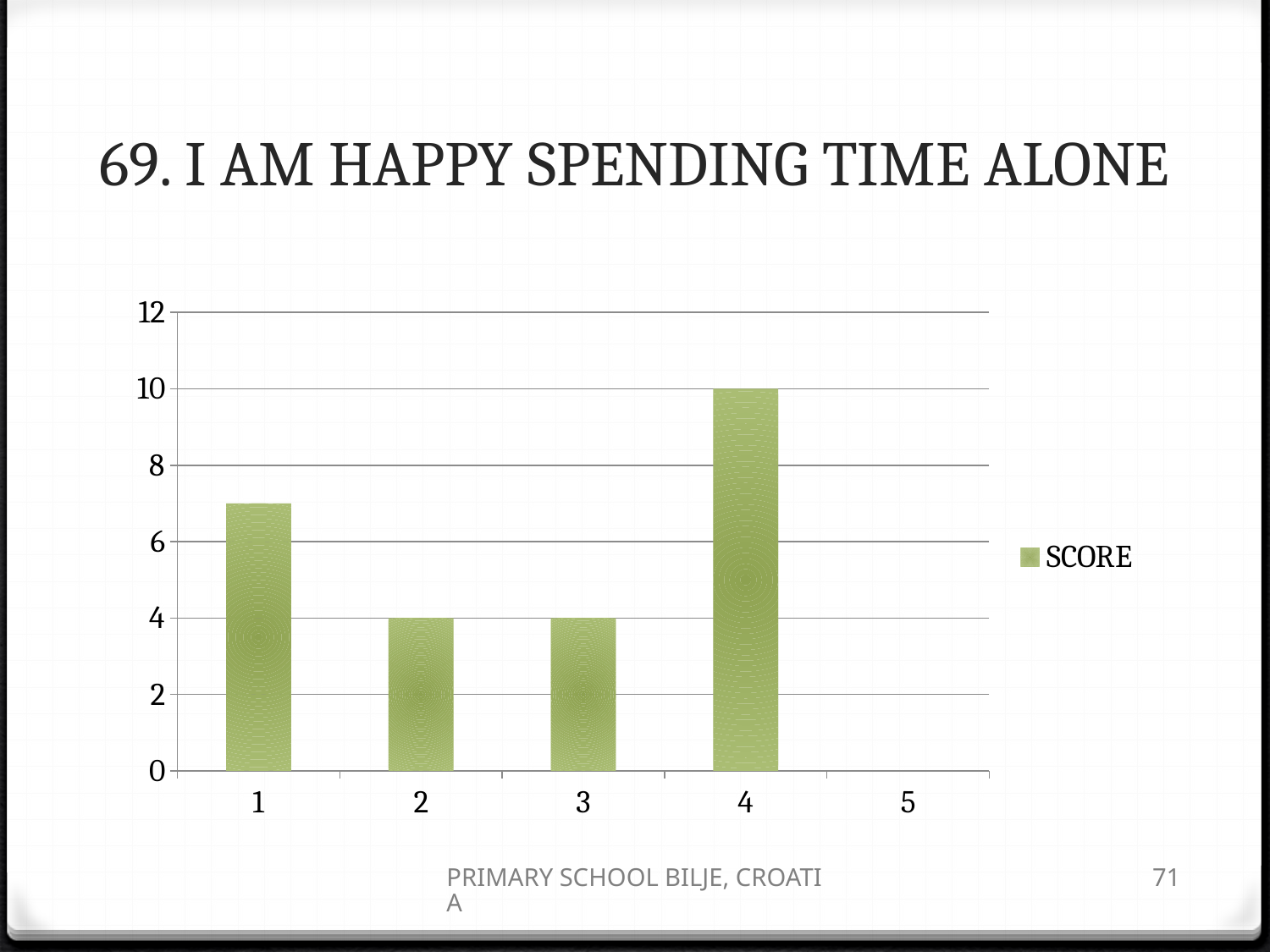
Is the SCORE value for category 1 greater or less than 6? greater What is the name of the series shown in the legend? SCORE Which category has the highest SCORE? 4 What is the difference between the SCORE for category 4 and the SCORE for category 2? 6 What is the SCORE value for category 3? 4 What is the SCORE value for category 2? 4 How many categories are shown on the x axis? 5 Is the SCORE value for category 1 greater or less than 8? less What kind of chart is shown on the slide? bar chart How many series does the legend list? 1 What is the SCORE value for category 4? 10 Which has a larger SCORE, category 1 or category 2? 1